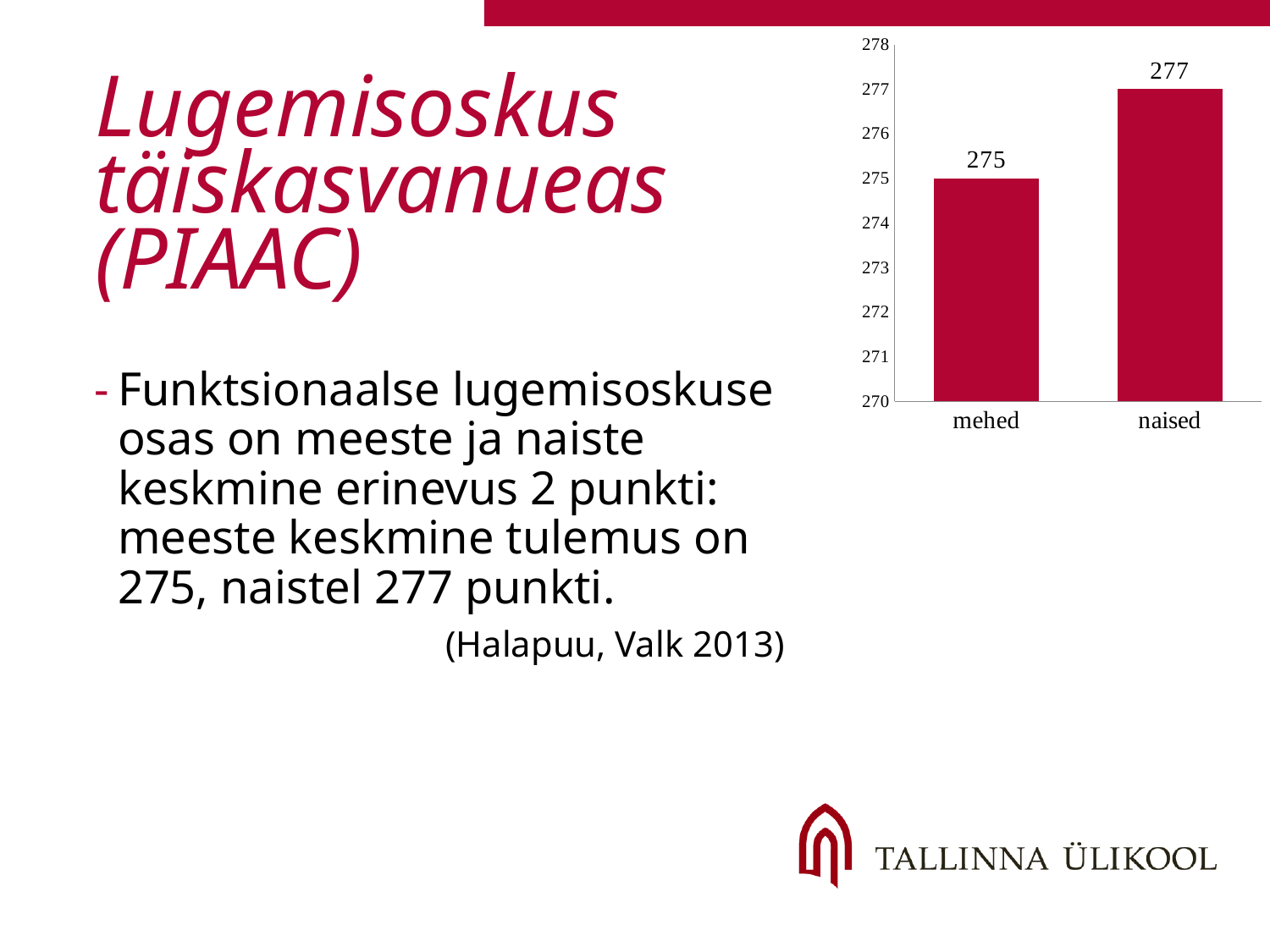
Is the value for mehed greater or less than 274? greater Which is larger, the value for mehed or the value for naised? naised Do the values rise or fall from mehed to naised? rise What is the value for mehed? 275 How many categories are shown on the x axis? 2 What is the lowest value shown on the y axis? 270 Which category has the highest value? naised What is the value for naised? 277 What kind of chart is shown on the slide? bar chart Which category has the lowest value? mehed What is the difference between the values for naised and mehed? 2 Is the value for naised greater or less than 278? less